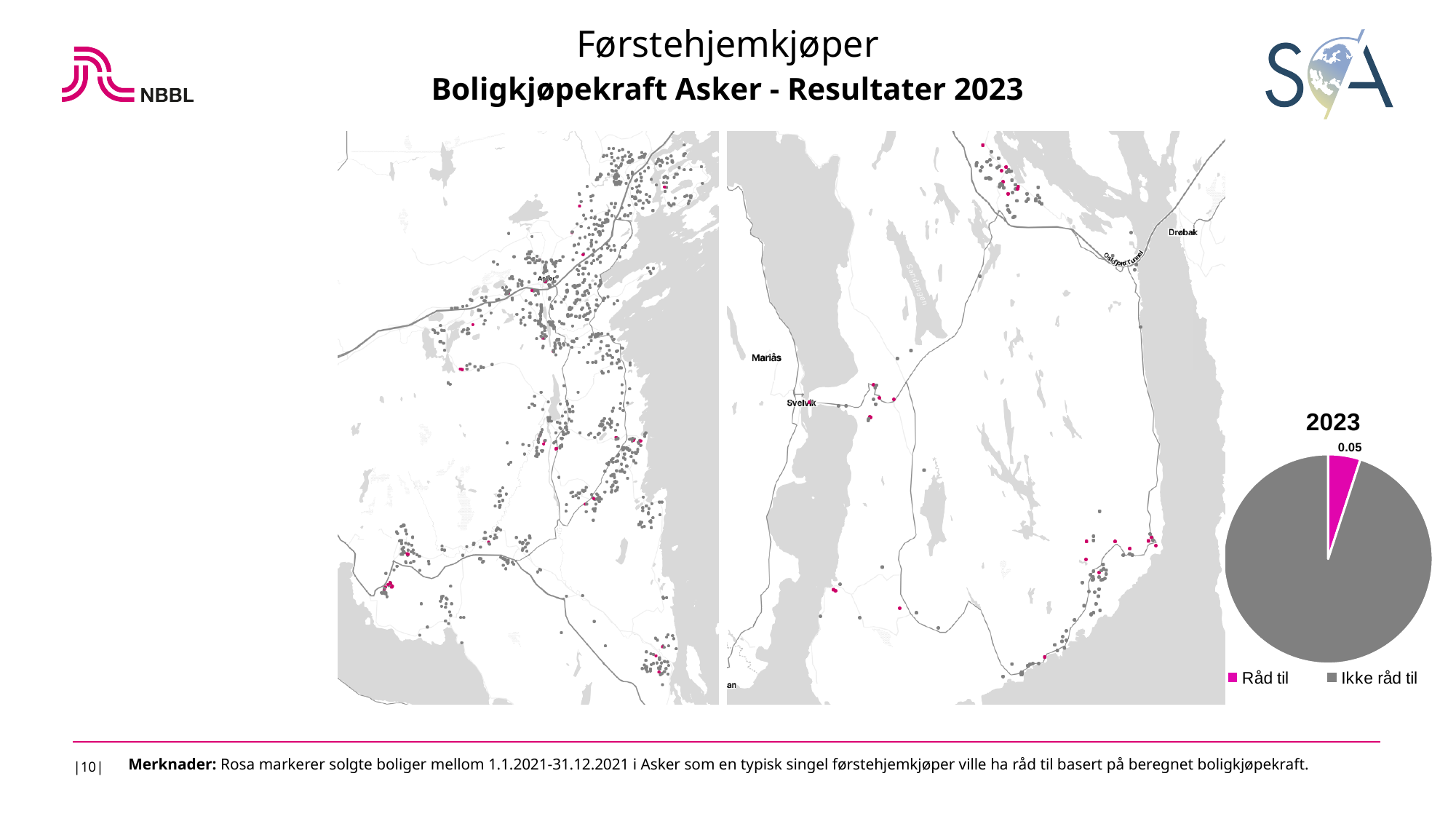
In the 2023 pie chart, what value is printed for the Råd til slice? 0.05 How many entries does the legend of the 2023 pie chart list? 2 What share of the 2023 pie chart does the Råd til slice represent, as labelled? 0.05 Which slice of the 2023 pie chart is the largest? Ikke råd til In the 2023 pie chart, which is larger: Råd til or Ikke råd til? Ikke råd til What is the title shown above the pie chart? 2023 What kind of chart is shown on the right side of the slide under the heading 2023? pie chart Which slice of the 2023 pie chart is the smallest? Råd til How many slices does the 2023 pie chart have? 2 What colour is the Råd til slice in the pie chart? pink